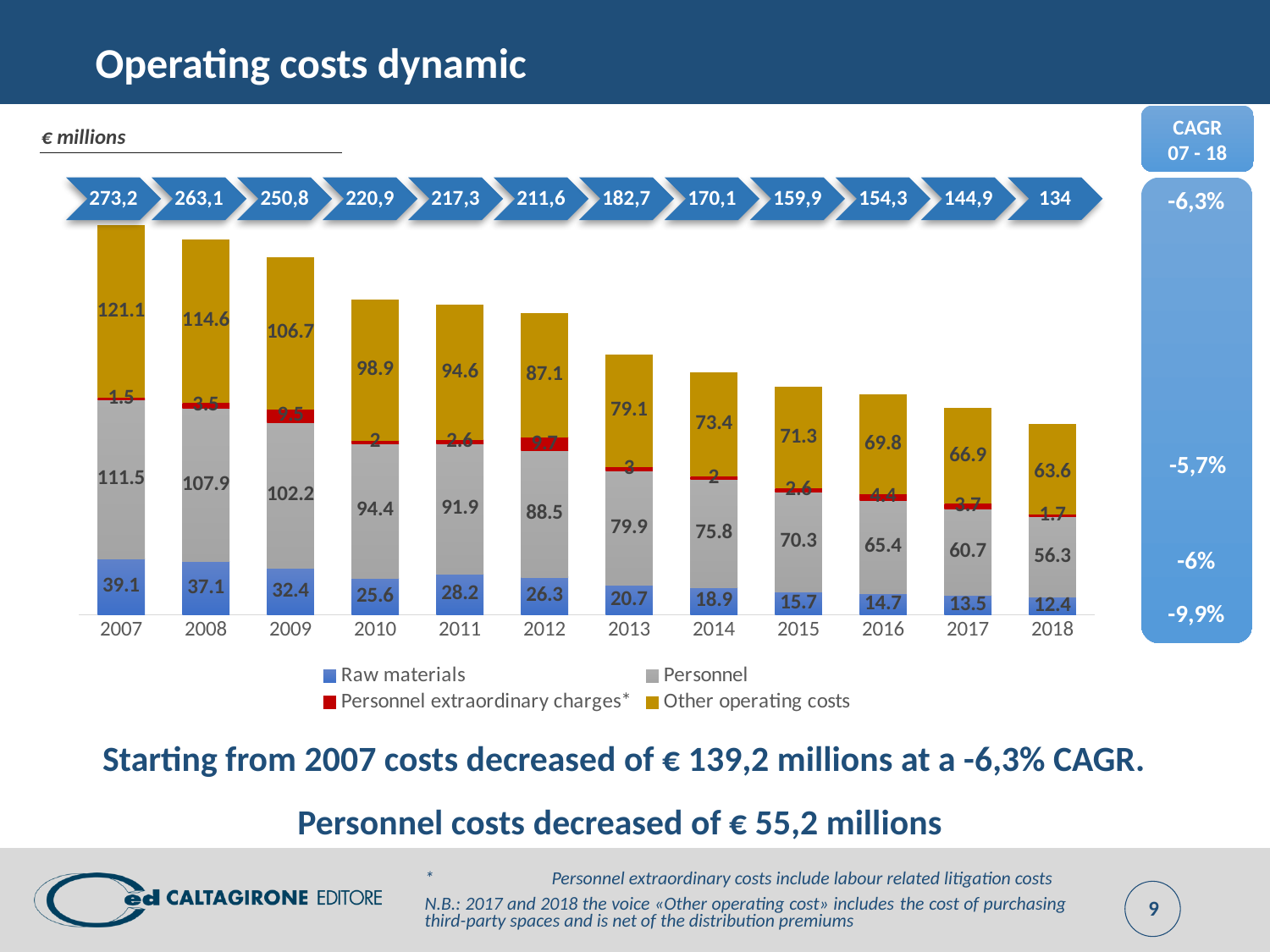
How many series does the legend list? 4 What kind of chart is shown on the slide? stacked bar chart What is the Raw materials value for 2018? 12.4 Do the Personnel values rise or fall from 2007 to 2018? fall What is the difference between the Personnel value in 2007 and in 2018? 55.2 What is the total operating cost shown for 2013? 182,7 What is the Other operating costs value for 2012? 87.1 What is the Personnel value for 2007? 111.5 Which year has the highest Other operating costs value? 2007 How many years are shown on the x axis? 12 Which year has the lowest Raw materials value? 2018 Which year has the larger Raw materials value, 2010 or 2011? 2011